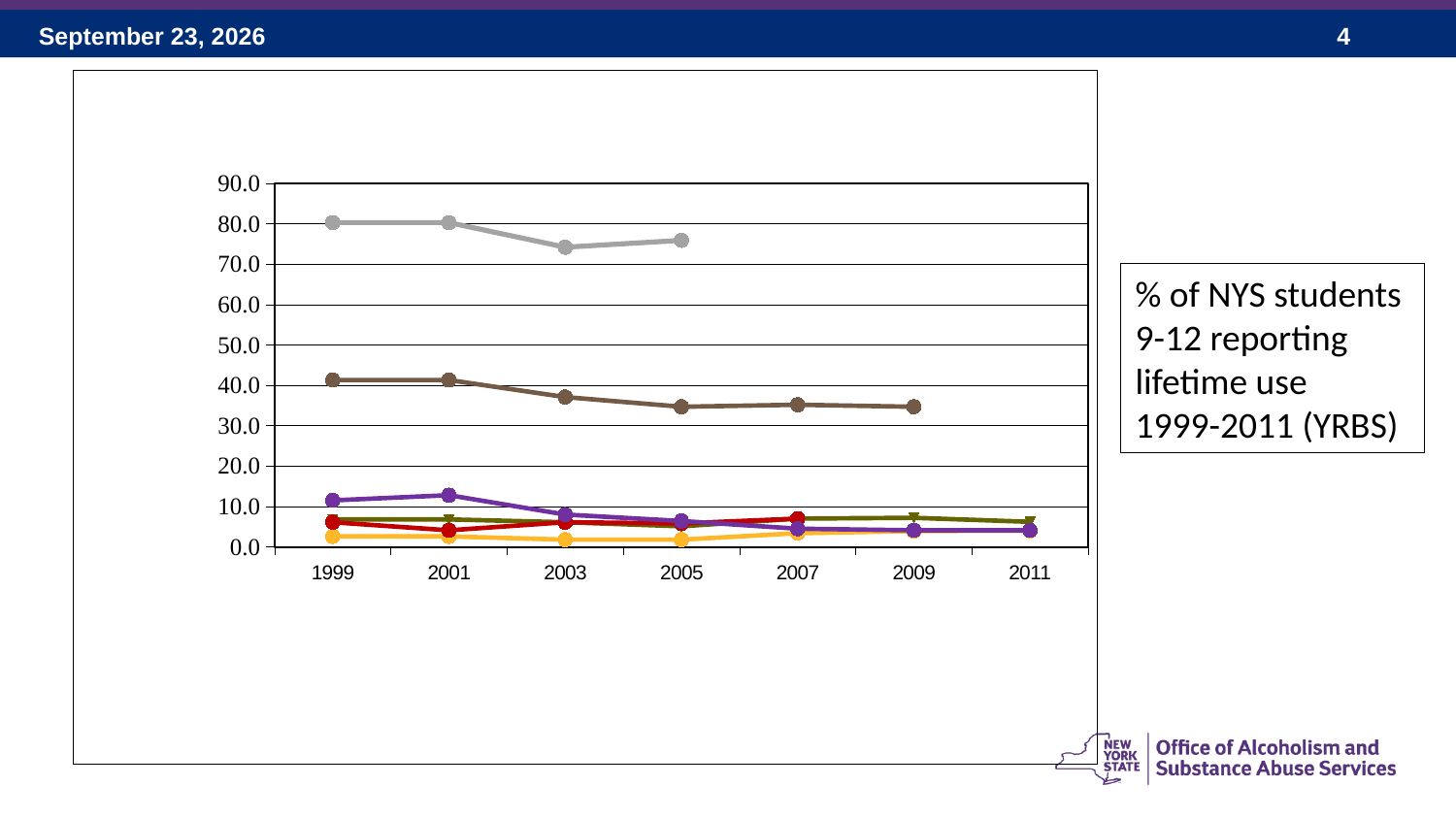
Is the value of the purple line in 2001 greater or less than 10? greater Is the value of the grey line in 2003 greater or less than 80? less In 2001, which is larger: the grey line or the brown line? the grey line Which line has the highest values across the chart? the grey line What is the first year shown on the x axis? 1999 Does the grey line rise or fall overall from 1999 to 2005? fall How many years are marked on the x axis of the chart? 7 Is the value of the brown line in 2005 greater or less than 40? less What kind of chart is shown on the slide? line chart What is the title text shown beside the chart? % of NYS students 9-12 reporting lifetime use 1999-2011 (YRBS)